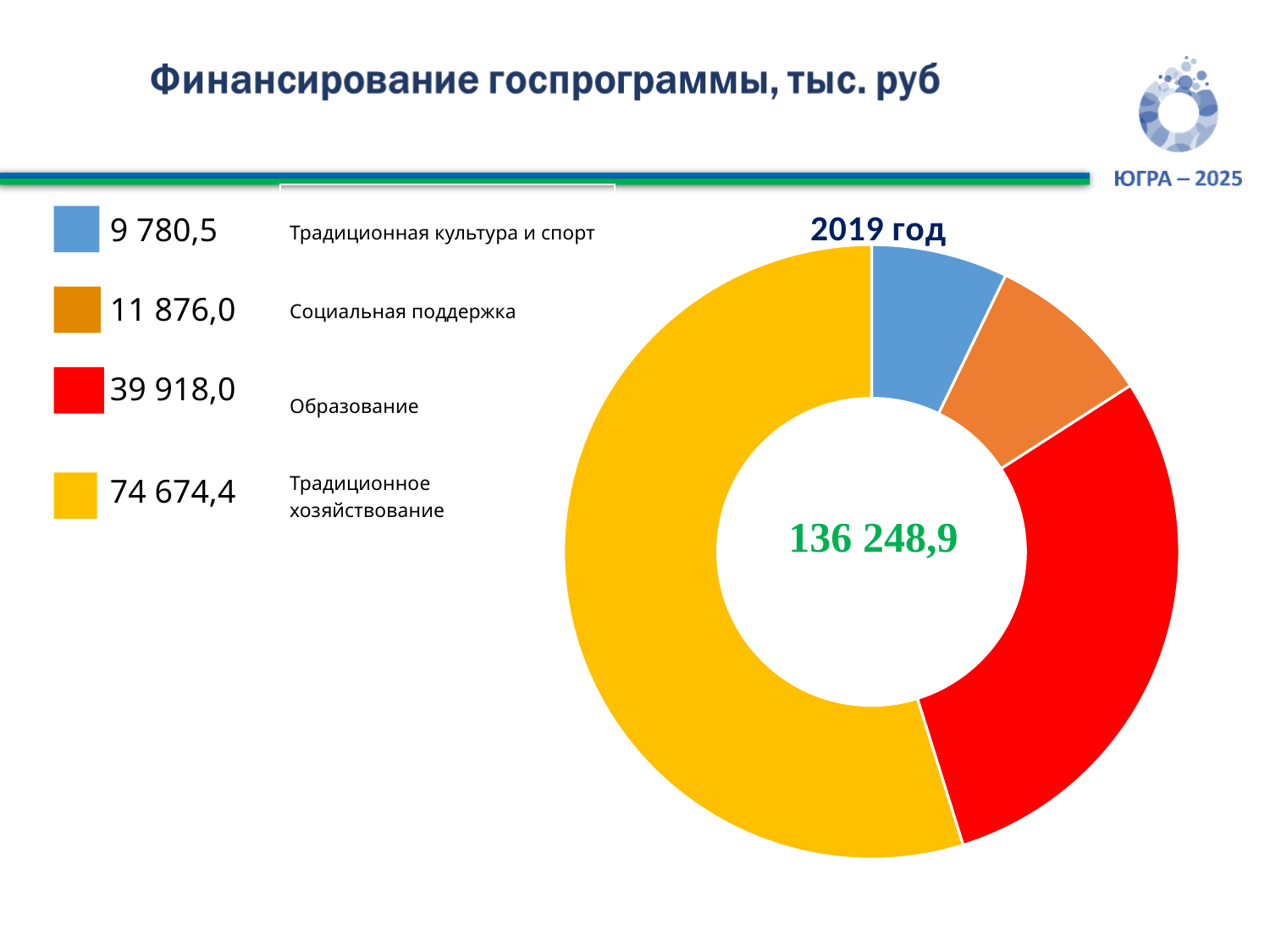
How many categories are shown in the chart? 4 What is the value for Образование? 39 918,0 What kind of chart is shown on the slide? Donut (pie) chart What is the difference between Социальная поддержка and Традиционная культура и спорт? 2 095,5 What is the difference between Традиционное хозяйствование and Образование? 34 756,4 Which is larger: Образование or Социальная поддержка? Образование Which category has the smallest value? Традиционная культура и спорт What is the total value shown in the centre of the chart? 136 248,9 What is the value for Традиционная культура и спорт? 9 780,5 What is the value for Социальная поддержка? 11 876,0 What is the value for Традиционное хозяйствование? 74 674,4 Which category has the largest value? Традиционное хозяйствование